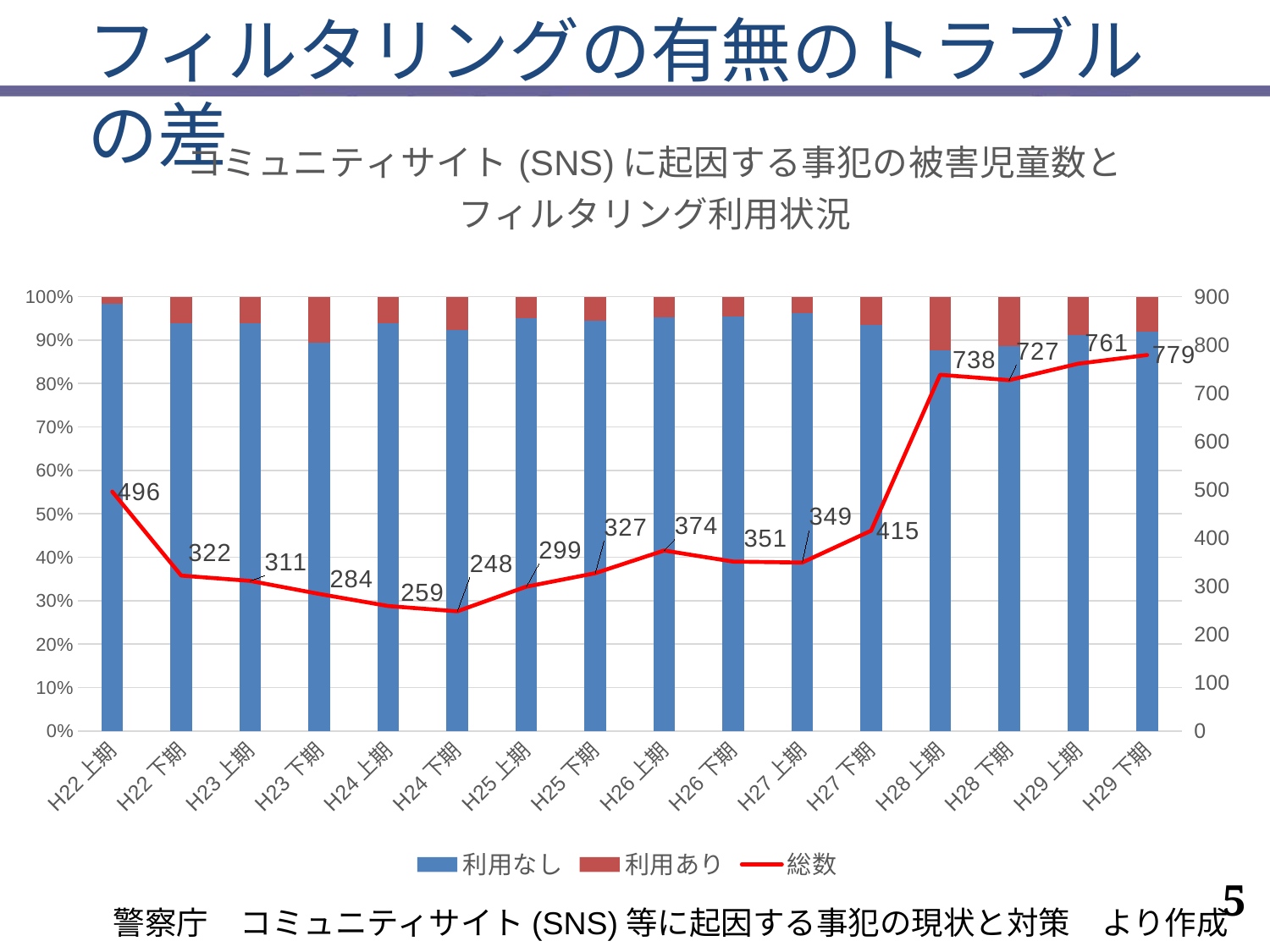
What is the difference between the 総数 values for H22 上期 and H22 下期? 174 How many series does the legend list? 3 Which is larger, the 総数 value for H26 上期 or for H27 上期? H26 上期 What is the value of 総数 for H22 上期? 496 What is the value of 総数 for H24 下期? 248 Does the 総数 line rise or fall from H22 上期 to H24 下期? fall What is the value of 総数 for H28 上期? 738 What is the difference between the 総数 values for H29 下期 and H29 上期? 18 Which period has the lowest 総数 value? H24 下期 Is the 利用なし share for H22 上期 greater or less than 90%? greater Which period has the highest 総数 value? H29 下期 How many periods are shown on the x axis? 16